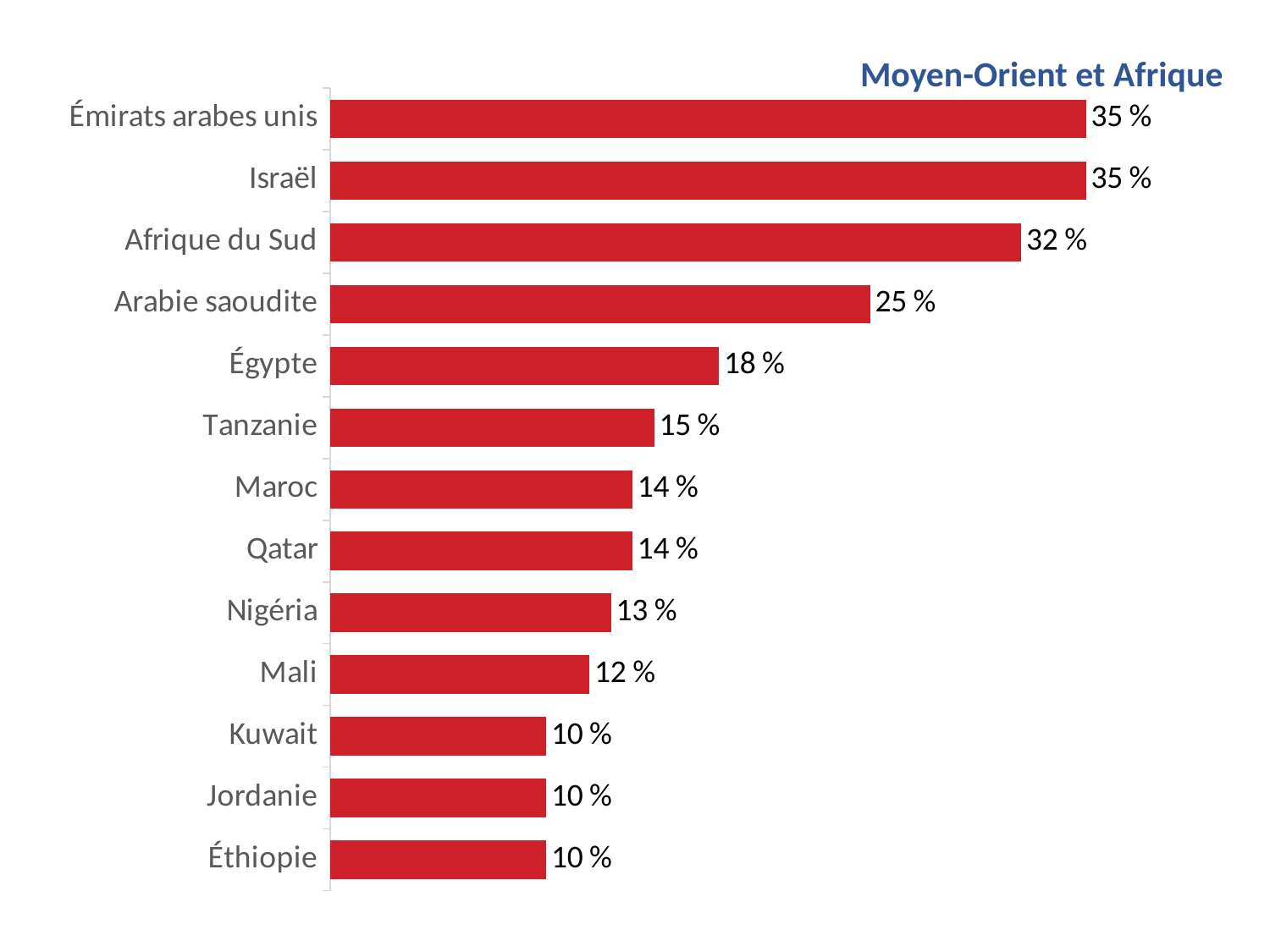
What is the value for Nigéria? 13 % Which is larger, the value for Tanzanie or the value for Kuwait? Tanzanie What is the value for Arabie saoudite? 25 % What is the value for Afrique du Sud? 32 % What is the difference between the values for Israël and Arabie saoudite? 10 % What is the title of the chart? Moyen-Orient et Afrique What is the difference between the values for Afrique du Sud and Égypte? 14 % What colour are the bars in the chart? Red Which category has the lowest value, Tanzanie or Mali? Mali How many categories are shown in the chart? 13 What is the value for Égypte? 18 % What kind of chart is shown on the slide? Bar chart